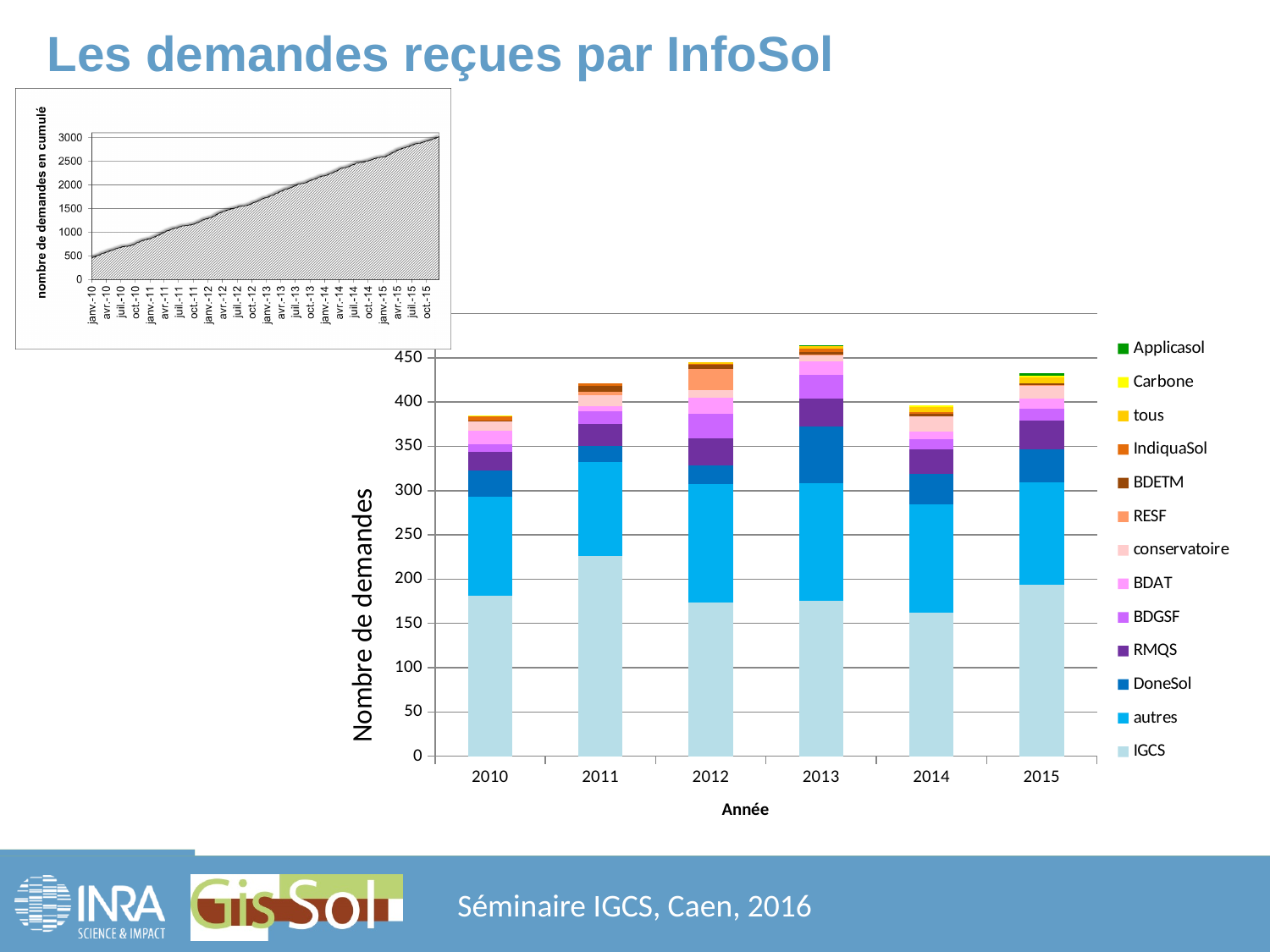
In the large bar chart, how many years are shown on the x axis? 6 In the large bar chart, how many series does the legend list? 13 In the large bar chart, is the total for 2010 greater or less than 400? less In the large bar chart, is the IGCS value for 2011 greater or less than 200? greater In the large bar chart, which year has the largest IGCS segment? 2011 What kind of chart is the large chart with years on the x axis? stacked bar chart In the large bar chart, which year has the tallest stacked bar overall? 2013 In the small chart at the top left, is the value at oct-15 greater or less than 2500? greater In the large bar chart, which total is larger, 2013 or 2014? 2013 In the small chart at the top left, do the values rise or fall from janv-10 to oct-15? rise In the large bar chart, what is the label of the y axis? Nombre de demandes